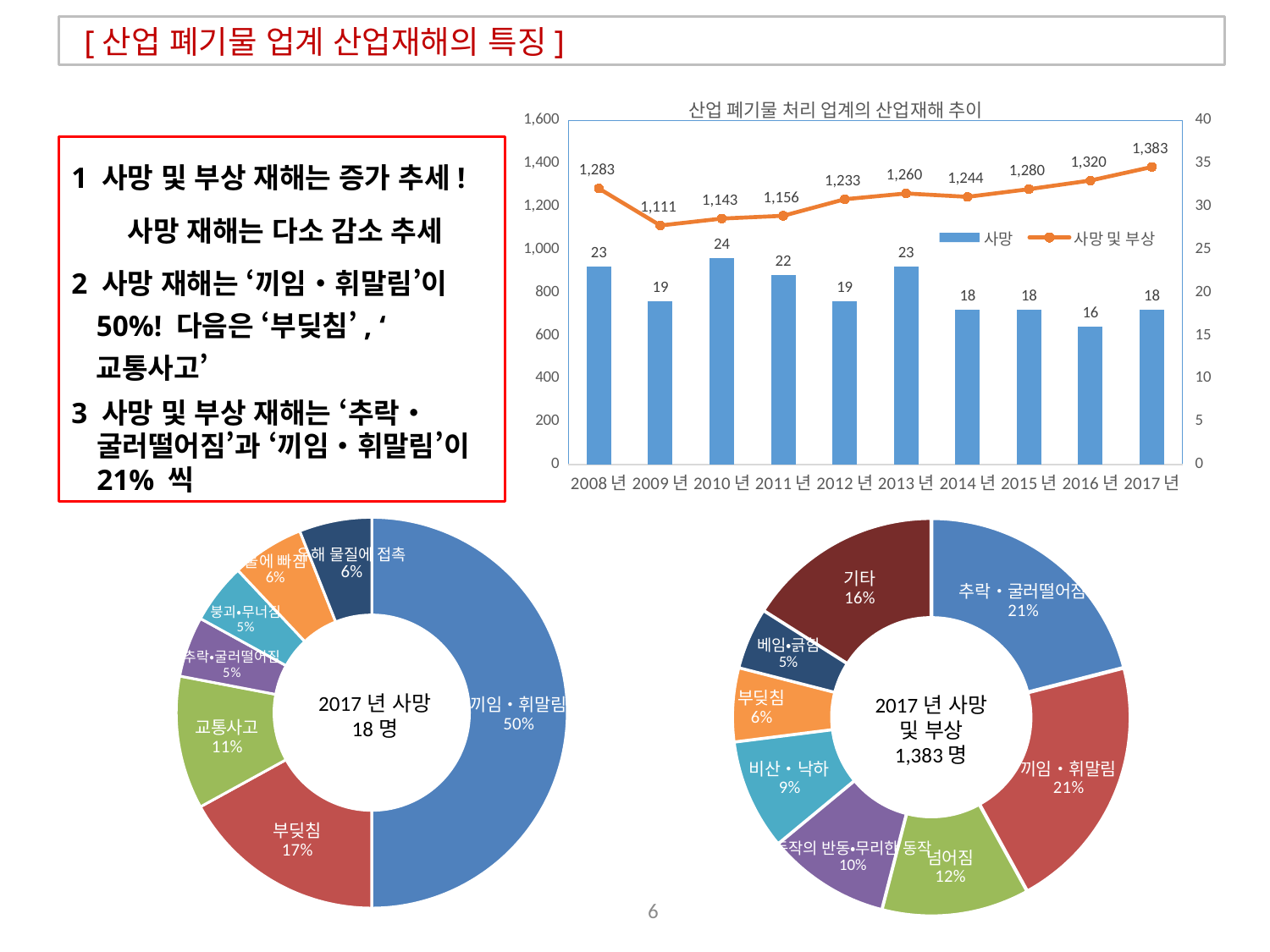
In the chart titled '산업 폐기물 처리 업계의 산업재해 추이', what kind of chart is it? Combined bar and line chart In the chart titled '산업 폐기물 처리 업계의 산업재해 추이', which year has the lowest 사망 value? 2016 년 In the chart titled '산업 폐기물 처리 업계의 산업재해 추이', how many series does the legend list? 2 In the donut chart labelled '2017 년 사망 및 부상 1,383 명', what share does 넘어짐 have? 12% In the chart titled '산업 폐기물 처리 업계의 산업재해 추이', which year has the highest 사망 value? 2010 년 In the donut chart labelled '2017 년 사망 18 명', what share does 끼임·휘말림 have? 50% In the chart titled '산업 폐기물 처리 업계의 산업재해 추이', what is the value of 사망 및 부상 for 2017 년? 1,383 In the chart titled '산업 폐기물 처리 업계의 산업재해 추이', how many years are shown on the x axis? 10 In the chart titled '산업 폐기물 처리 업계의 산업재해 추이', how much higher is 사망 및 부상 in 2017 년 than in 2008 년? 100 In the donut chart labelled '2017 년 사망 및 부상 1,383 명', which is larger, 기타 or 비산·낙하? 기타 In the chart titled '산업 폐기물 처리 업계의 산업재해 추이', which year has the lowest 사망 및 부상 value? 2009 년 In the chart titled '산업 폐기물 처리 업계의 산업재해 추이', what is the value of 사망 for 2010 년? 24